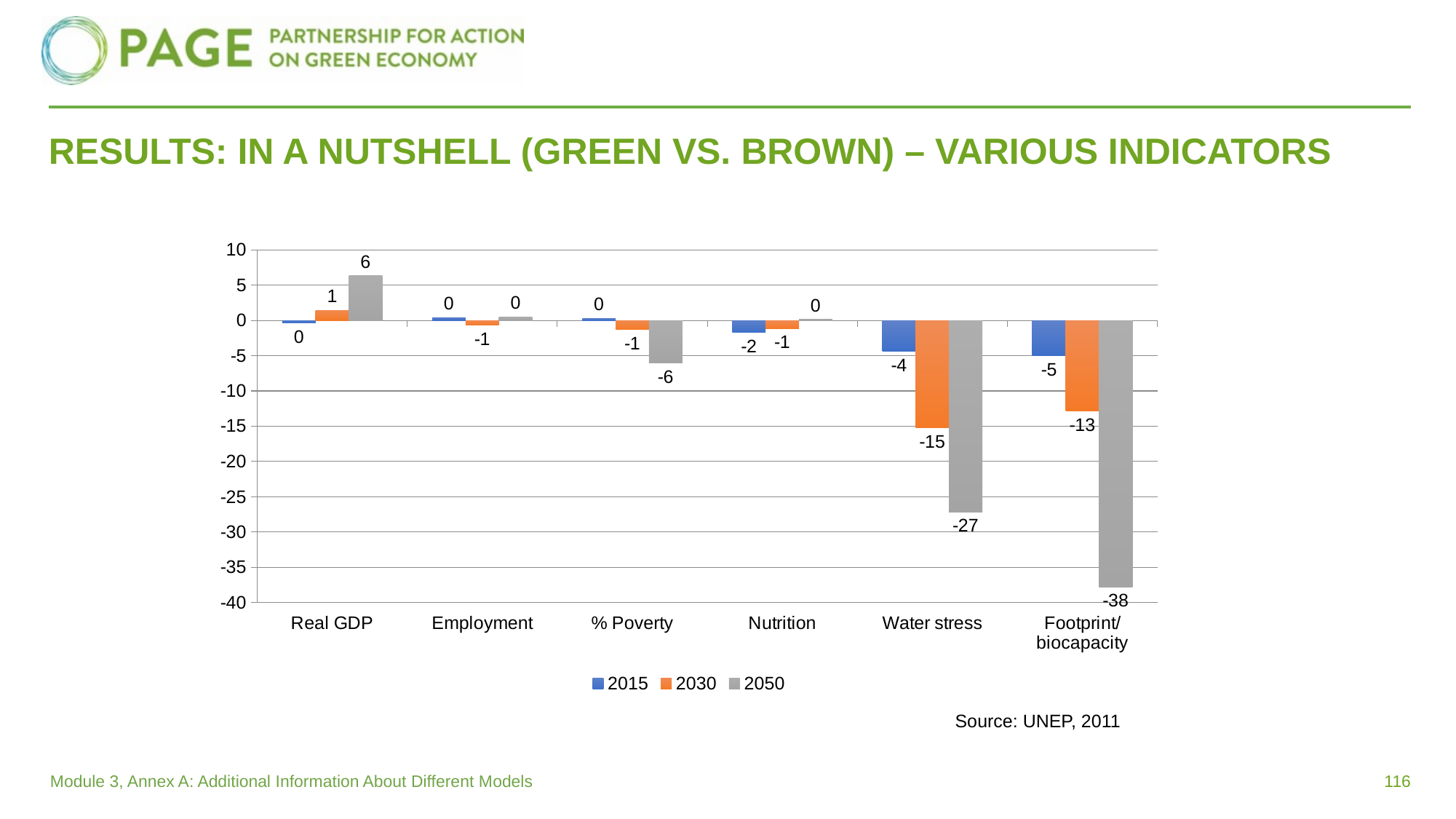
What is the value for Footprint/biocapacity in the 2050 series? -38 What source is cited below the chart? UNEP, 2011 Which category has the lowest value in the 2050 series? Footprint/biocapacity Which is lower in the 2050 series: Water stress or Footprint/biocapacity? Footprint/biocapacity What is the value for Nutrition in the 2015 series? -2 What is the value for Real GDP in the 2050 series? 6 What is the difference between the 2030 and 2050 values for Water stress? 12 How many series does the legend list? 3 How many categories are shown on the x axis? 6 What is the value for Water stress in the 2030 series? -15 What kind of chart is shown on the slide? Bar chart Which category has the highest value in the 2050 series? Real GDP